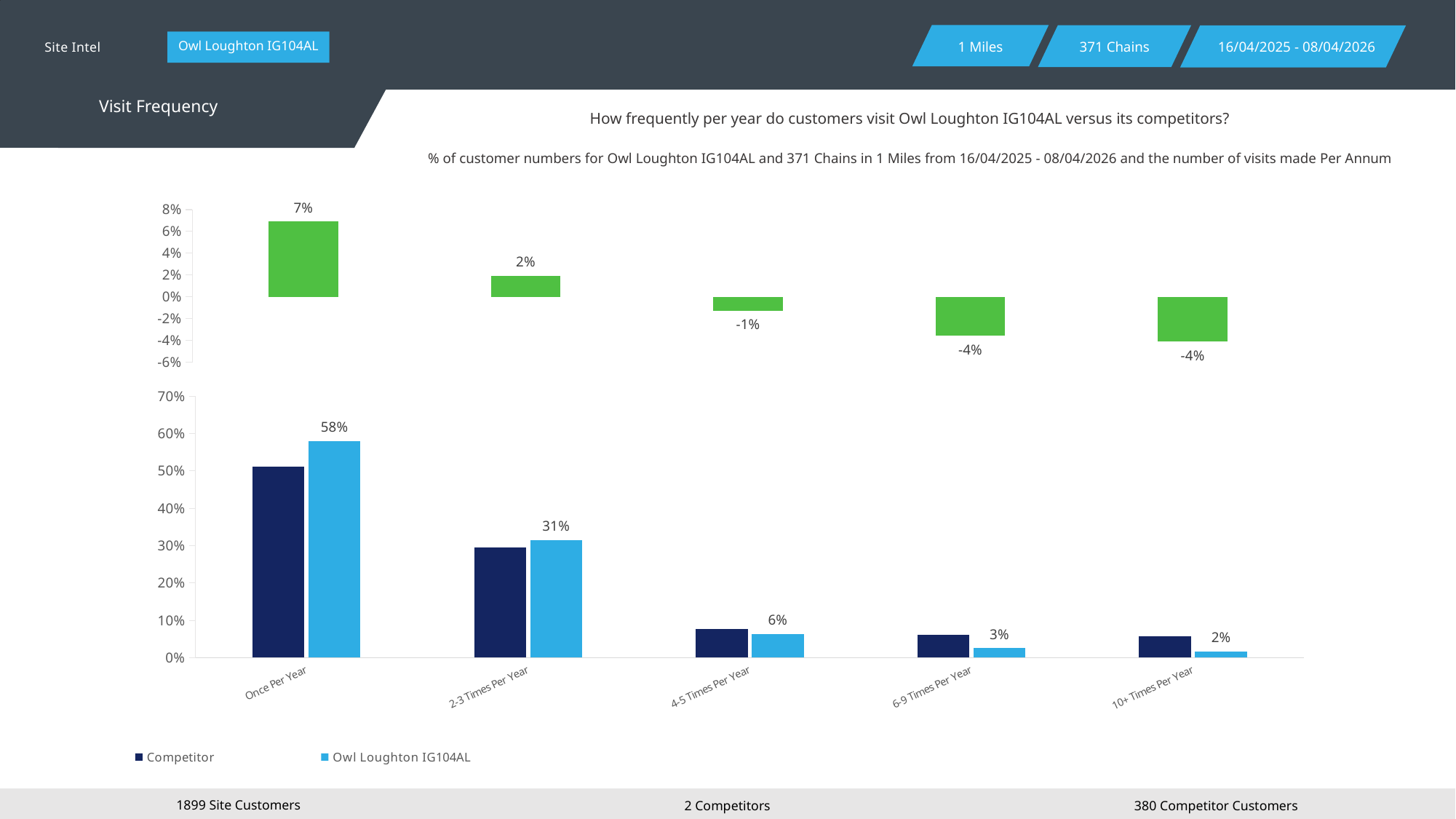
In the bottom chart, which is larger for 4-5 Times Per Year: the Competitor bar or the Owl Loughton IG104AL bar? Competitor In the bottom chart, what is the difference between the Owl Loughton IG104AL values for Once Per Year and 2-3 Times Per Year? 27% In the bottom chart, what is the value for Owl Loughton IG104AL for 6-9 Times Per Year? 3% In the bottom chart, do the Owl Loughton IG104AL values rise or fall from Once Per Year to 10+ Times Per Year? fall In the bottom chart, what is the value for Owl Loughton IG104AL for Once Per Year? 58% In the bottom chart, which category has the lowest value for Owl Loughton IG104AL? 10+ Times Per Year In the bottom chart, is the Competitor value for Once Per Year greater or less than 40%? greater How many series does the legend of the bottom chart list? 2 In the bottom chart, what is the value for Owl Loughton IG104AL for 2-3 Times Per Year? 31% In the top chart, which category has the highest value? Once Per Year In the top chart, what is the value shown for 4-5 Times Per Year? -1% In the top chart, what is the value shown for Once Per Year? 7%